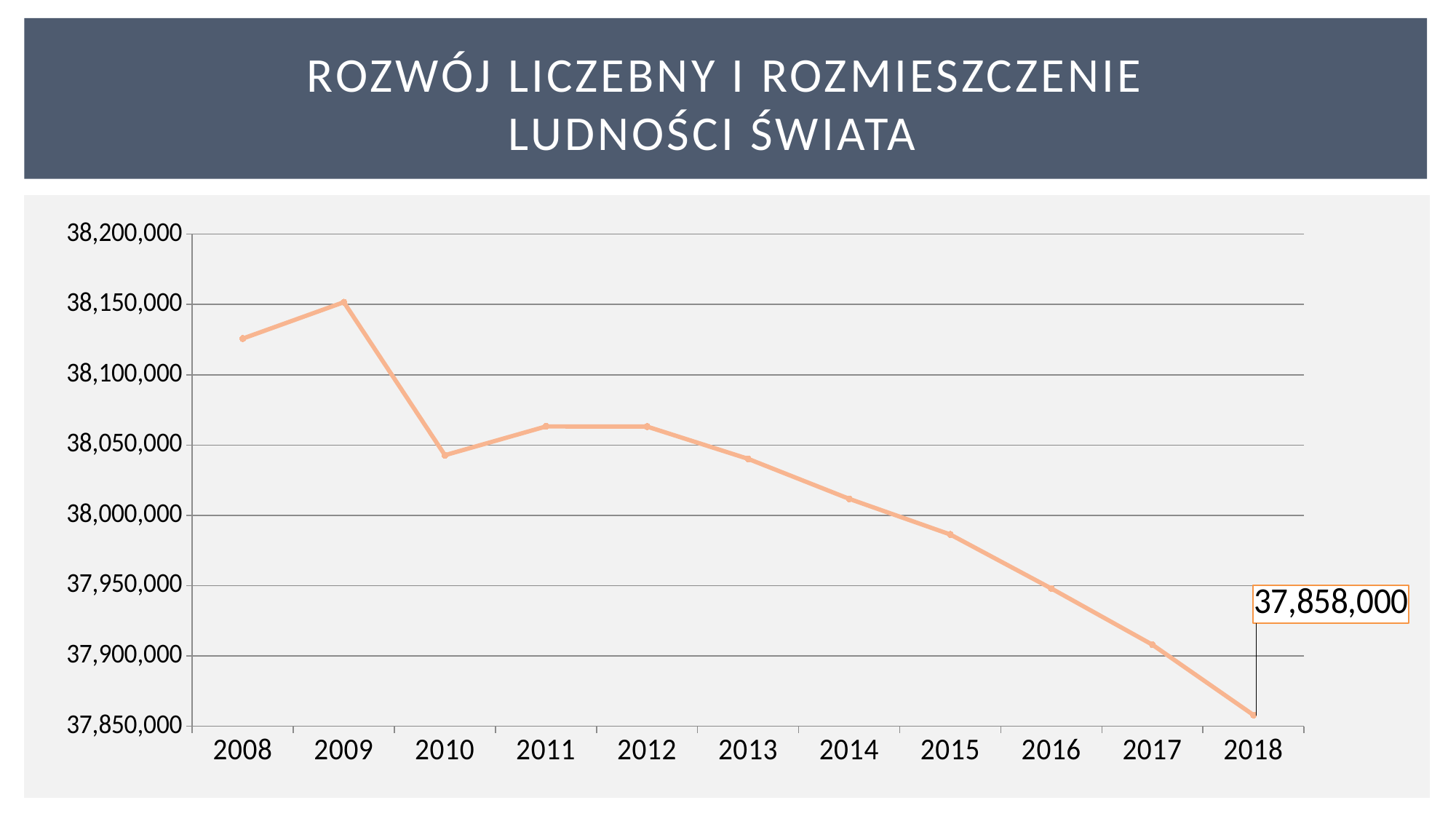
Which year has the lowest value? 2018 Is the value for 2015 greater or less than 38,000,000? less Is the value for 2011 greater or less than 38,050,000? greater Which is larger, the value for 2009 or the value for 2010? 2009 Which year has the highest value? 2009 What is the title of the slide? ROZWÓJ LICZEBNY I ROZMIESZCZENIE LUDNOŚCI ŚWIATA Which is larger, the value for 2008 or the value for 2018? 2008 Do the values rise or fall from 2012 to 2018? fall What kind of chart is shown on the slide? line chart What is the value shown for 2018? 37,858,000 How many years are plotted on the x axis? 11 Is the value for 2008 greater or less than 38,100,000? greater